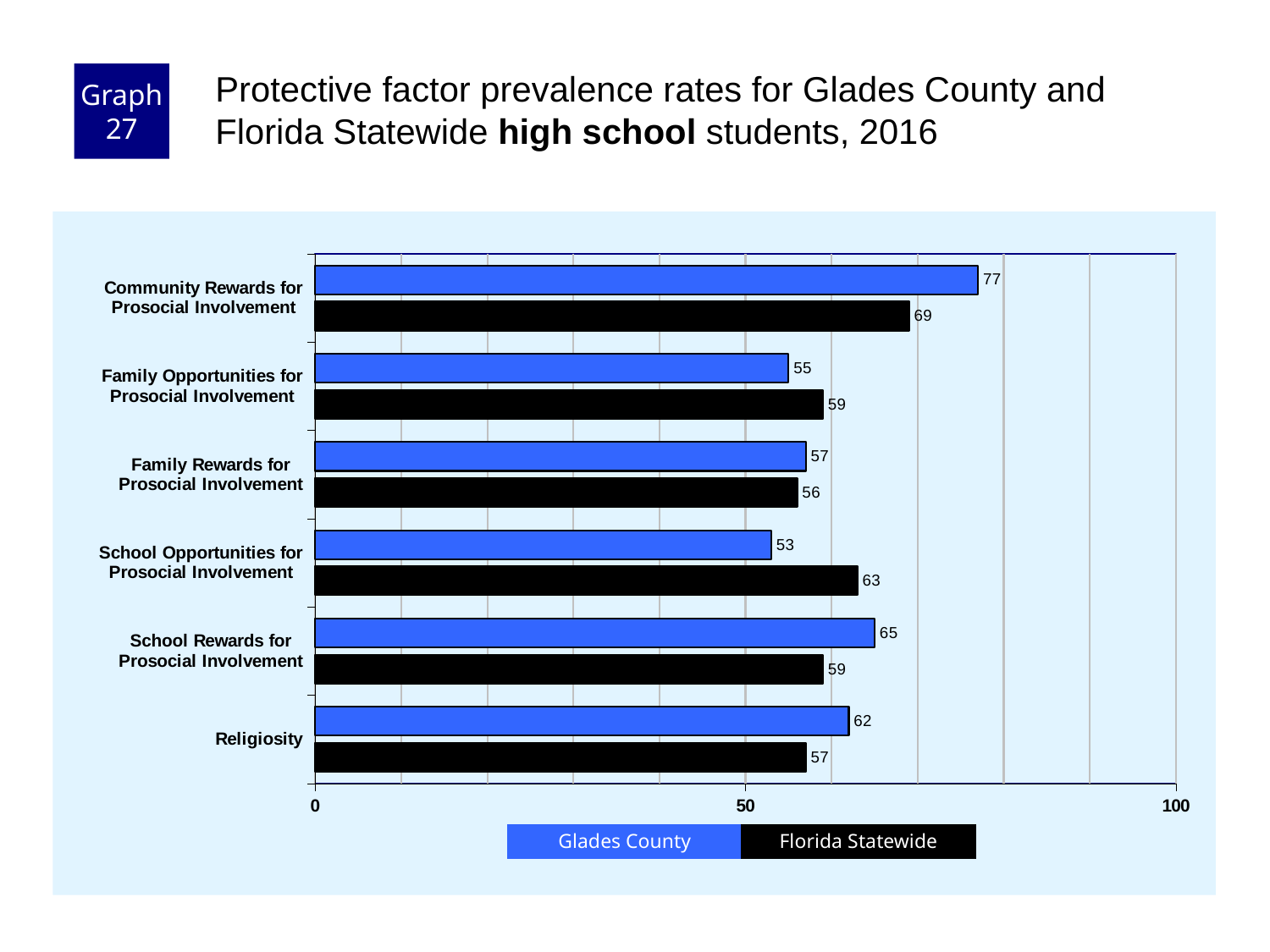
What is the Glades County value for Religiosity? 62 What kind of chart is shown on the slide? Bar chart How many protective factors are shown on the chart? 6 What is the Glades County value for Community Rewards for Prosocial Involvement? 77 What is the difference between the Glades County and Florida Statewide values for Community Rewards for Prosocial Involvement? 8 What is the Florida Statewide value for School Opportunities for Prosocial Involvement? 63 How many series does the legend list? 2 Is the Florida Statewide value for Family Rewards for Prosocial Involvement greater or less than 50? greater Which protective factor has the lowest Glades County value? School Opportunities for Prosocial Involvement Which protective factor has the highest Glades County value? Community Rewards for Prosocial Involvement What is the difference between the Glades County and Florida Statewide values for School Opportunities for Prosocial Involvement? 10 For School Rewards for Prosocial Involvement, which is larger: the Glades County value or the Florida Statewide value? Glades County